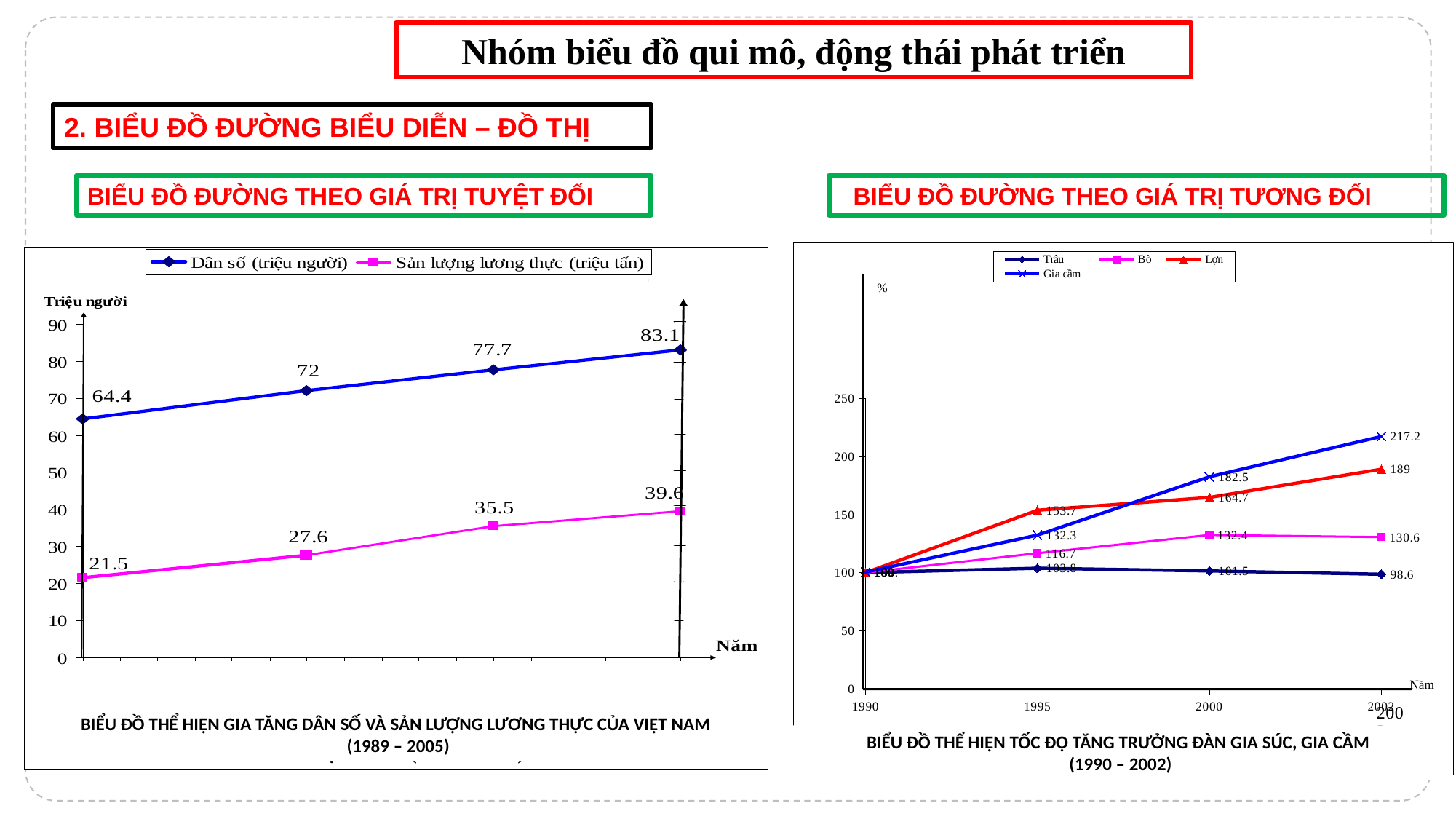
In the left chart (population and food production), what is the first data label on the Sản lượng lương thực (triệu tấn) line? 21.5 In the right chart (livestock growth rate), which series has the lowest value in 2002? Trâu In the left chart (population and food production), how many series does the legend list? 2 In the right chart (livestock growth rate), which is larger in 2000: Gia cầm or Lợn? Gia cầm In the right chart (livestock growth rate), how many years are shown on the x axis? 4 In the left chart (population and food production), what is the difference between the first and last values of the Dân số line (64.4 and 83.1)? 18.7 In the left chart (population and food production), does the Sản lượng lương thực line rise or fall from left to right? rise In the right chart (livestock growth rate), what is the difference between Lợn and Bò in 2002 (189 and 130.6)? 58.4 What kind of chart is the right chart (livestock growth rate)? line chart In the right chart (livestock growth rate), what is the value for Gia cầm in 2002? 217.2 In the left chart (population and food production), what is the last data label on the Dân số (triệu người) line? 83.1 In the right chart (livestock growth rate), what is the value for Lợn in 1995? 153.7